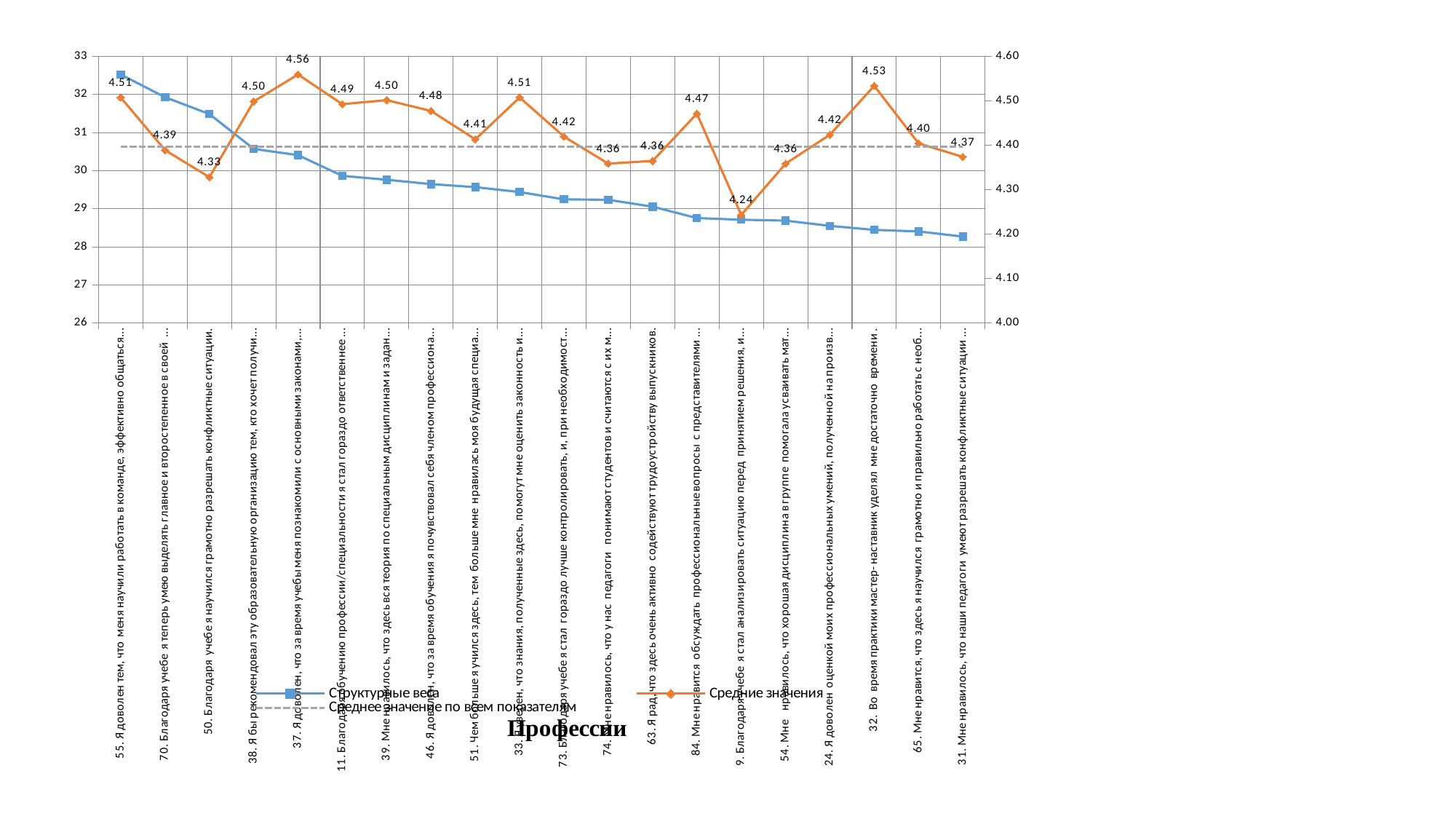
What type of chart is shown on the slide? line chart What is the difference between the highest (4.56) and lowest (4.24) values of the Средние значения series? 0.32 What is the value of the Средние значения series for the category numbered 37 ("Я доволен, что за время учебы меня познакомили с основными законами...")? 4.56 Which category has the highest value in the Средние значения series? 37. Я доволен, что за время учебы меня познакомили с основными законами... How many entries does the legend list? 3 Which category has the lowest value in the Средние значения series? 9. Благодаря учебе я стал анализировать ситуацию перед принятием решения... Does the Структурные веса series rise or fall from left to right along the x axis? fall What is the value of the Средние значения series for the category numbered 9 ("Благодаря учебе я стал анализировать ситуацию перед принятием решения...")? 4.24 How many categories are plotted along the x axis? 20 Is the Структурные веса value for the first category (55) greater or less than 32? greater Which is larger in the Средние значения series: the value for category 32 ("Во время практики мастер-наставник уделял мне достаточно времени") or for category 50 ("Благодаря учебе я научился грамотно разрешать конфликтные ситуации")? 32. Во время практики мастер-наставник уделял мне достаточно времени (4.53)